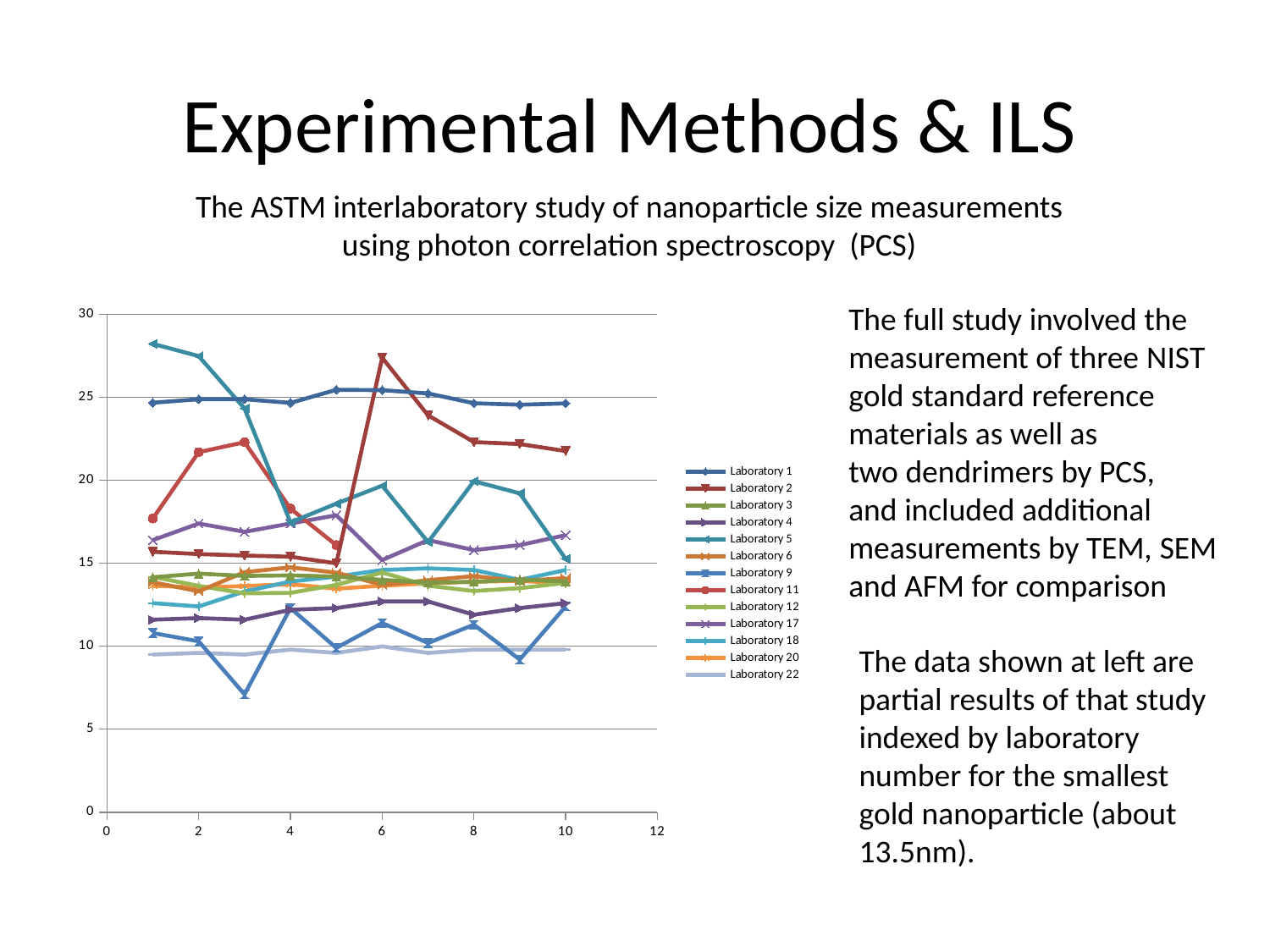
Do the values for Laboratory 2 rise or fall from x = 6 to x = 10? fall Is the value for Laboratory 2 at x = 6 greater or less than 25? greater How many series does the chart legend list? 13 What kind of chart is shown on the slide? line chart Is the value for Laboratory 5 at x = 1 greater or less than 25? greater At x = 5, which is larger: the value for Laboratory 1 or the value for Laboratory 22? Laboratory 1 Is the value for Laboratory 22 at x = 5 greater or less than 15? less Which series has the lowest value at x = 3? Laboratory 9 Which series has the highest value at x = 1? Laboratory 5 How many data points does the Laboratory 1 series have? 10